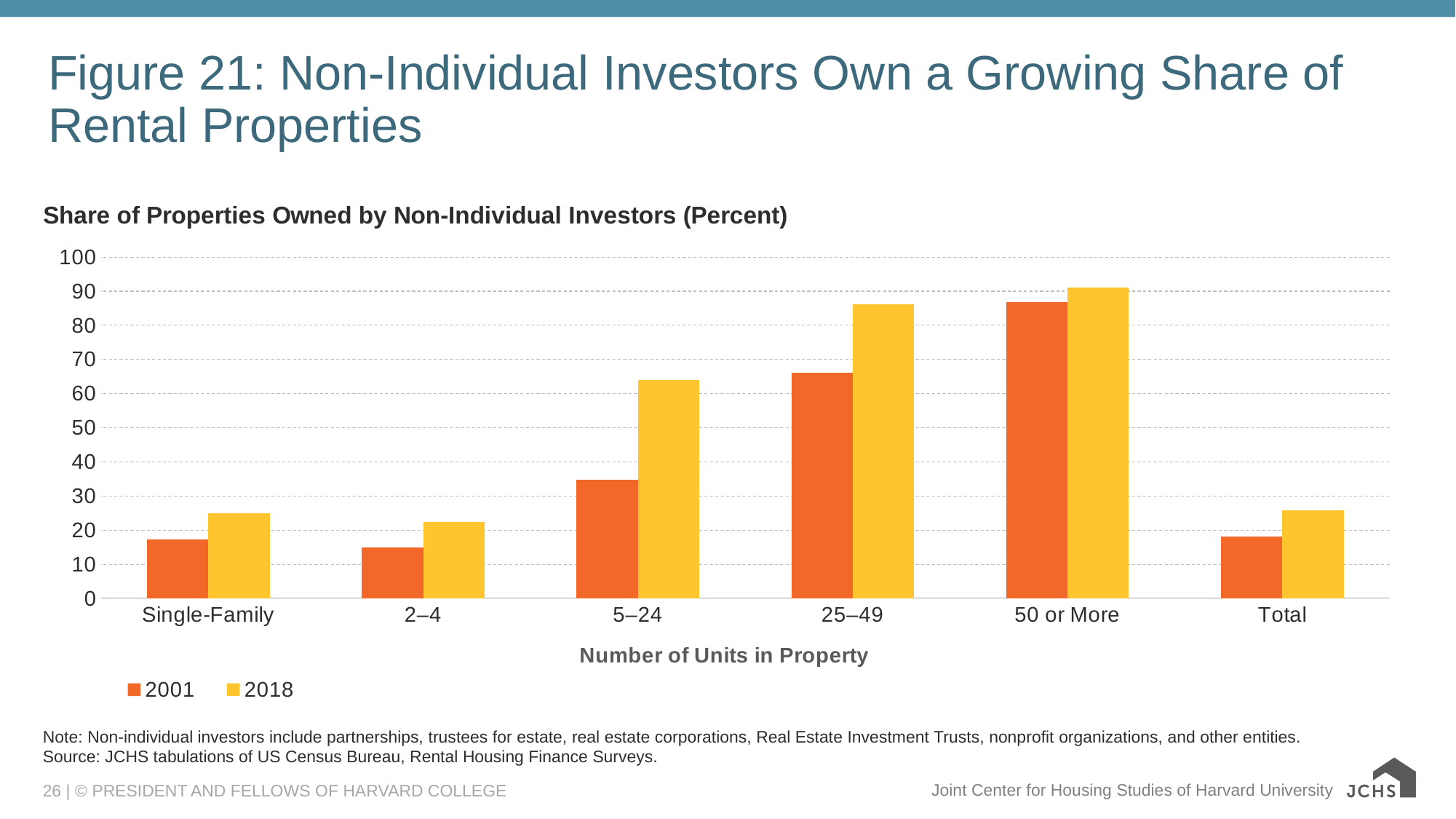
Is the 2018 value for 5–24 greater or less than 60? greater Which category has the highest value for 2018? 50 or More How many categories are shown along the x axis? 6 What kind of chart is shown on the slide? Bar chart What is the title of the x axis? Number of Units in Property How many series does the legend list? 2 Which category has the lowest value for 2001? 2–4 Which is larger: the 2001 value for 25–49 or the 2001 value for 5–24? 25–49 Is the 2001 value for Total greater or less than 20? less For the 5–24 category, which year has the larger value, 2001 or 2018? 2018 Which category has the highest value for 2001? 50 or More Is the 2001 value for 50 or More greater or less than 90? less